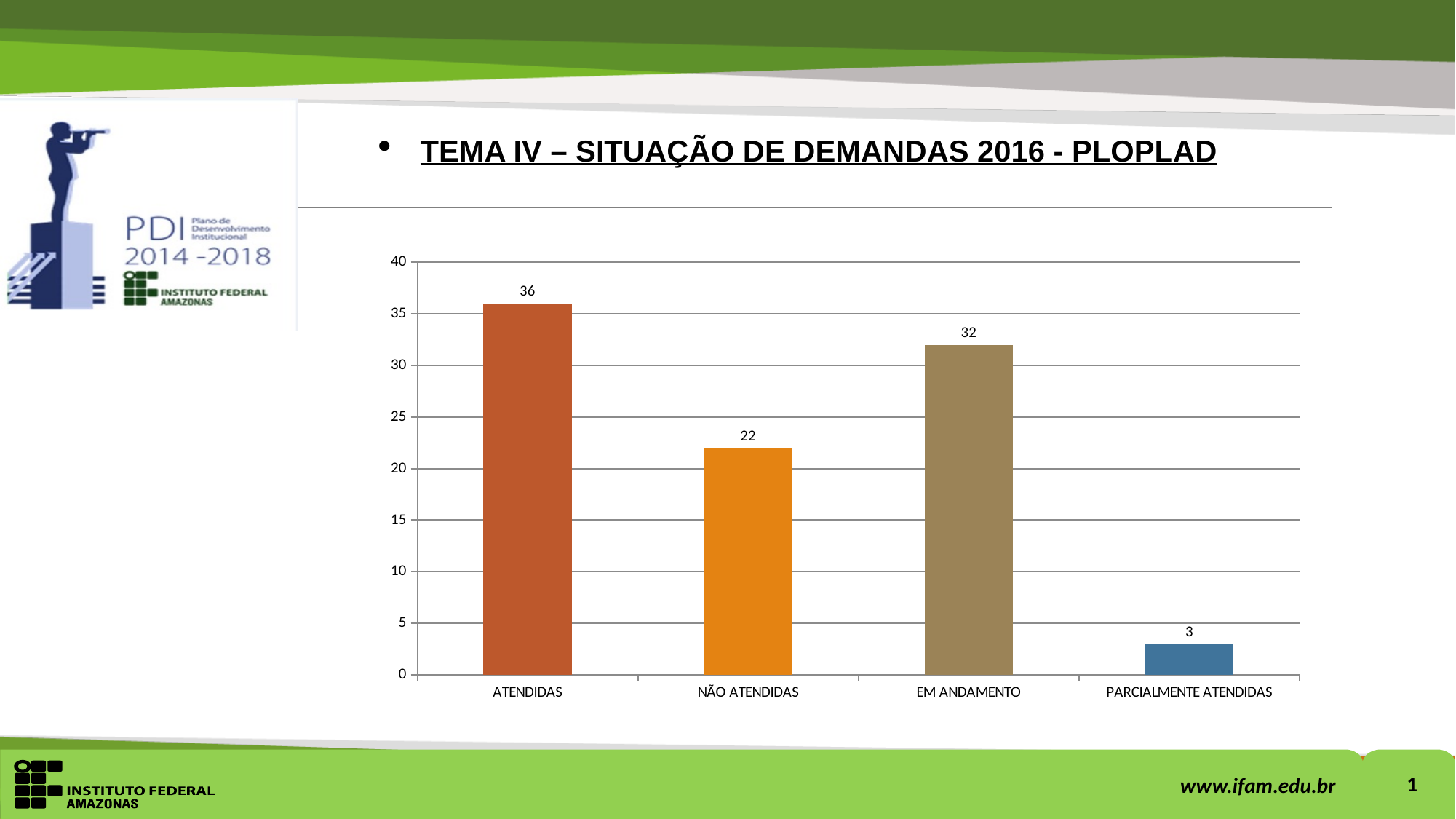
What is the value for NÃO ATENDIDAS? 22 How many categories are shown on the x axis? 4 What is the value for PARCIALMENTE ATENDIDAS? 3 What is the difference between the values for ATENDIDAS and EM ANDAMENTO? 4 What is the value for ATENDIDAS? 36 Which is larger, the value for NÃO ATENDIDAS or the value for EM ANDAMENTO? EM ANDAMENTO What is the difference between the values for NÃO ATENDIDAS and PARCIALMENTE ATENDIDAS? 19 Which category has the lowest value? PARCIALMENTE ATENDIDAS What is the title of the slide above the chart? TEMA IV – SITUAÇÃO DE DEMANDAS 2016 - PLOPLAD What is the value for EM ANDAMENTO? 32 Which category has the highest value? ATENDIDAS What kind of chart is shown on the slide? bar chart